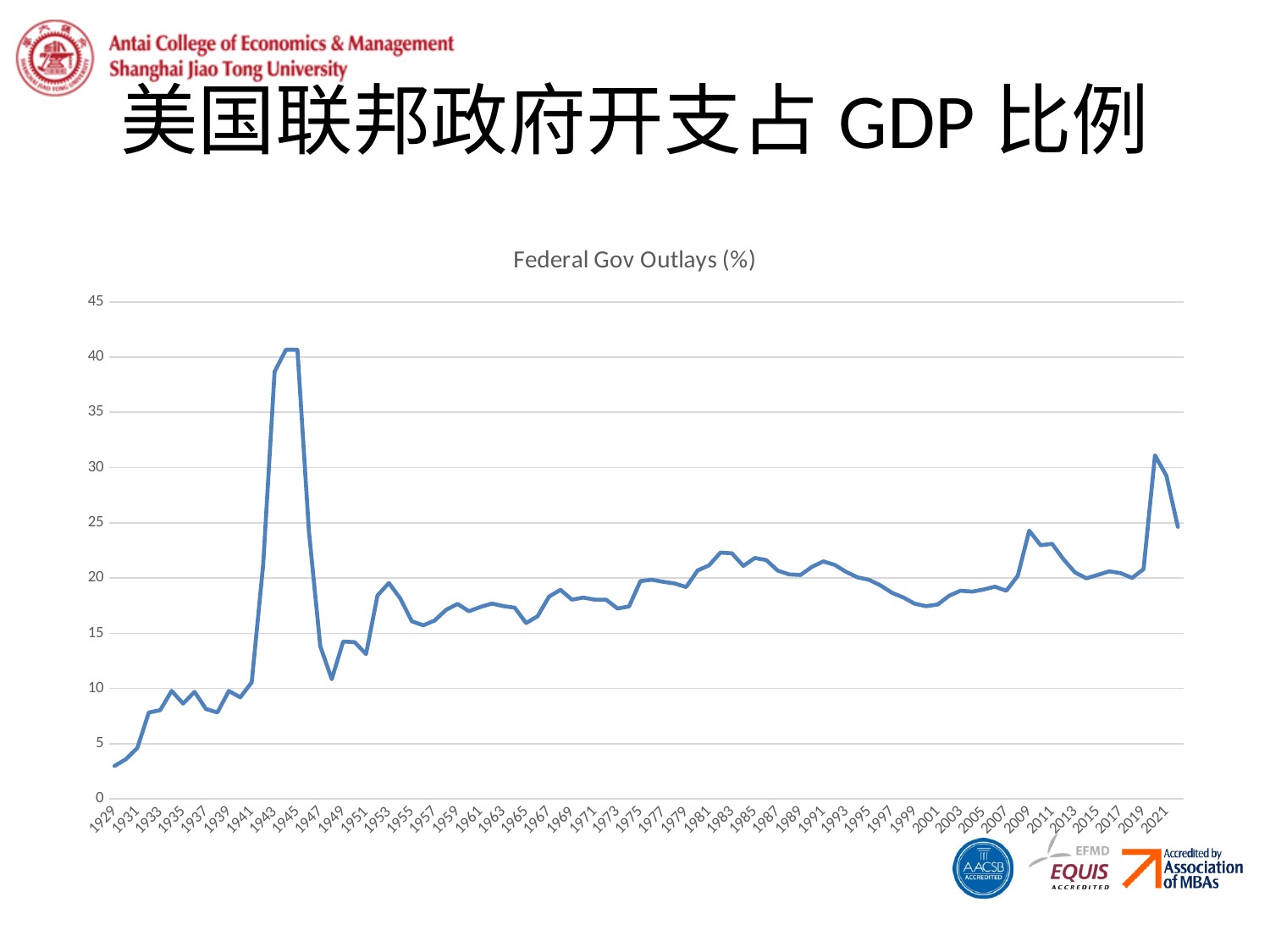
Is the value for 1929 greater or less than 5? less What is the first year shown on the x axis? 1929 Is the value for 2000 greater or less than 20? less Is the value for 1933 greater or less than 10? less What is the title of the chart? Federal Gov Outlays (%) What kind of chart is shown on the slide? line chart Does the value rise or fall from 1929 to 1944? rise Which year has the lowest value on the chart? 1929 Does the value rise or fall from 1945 to 1948? fall